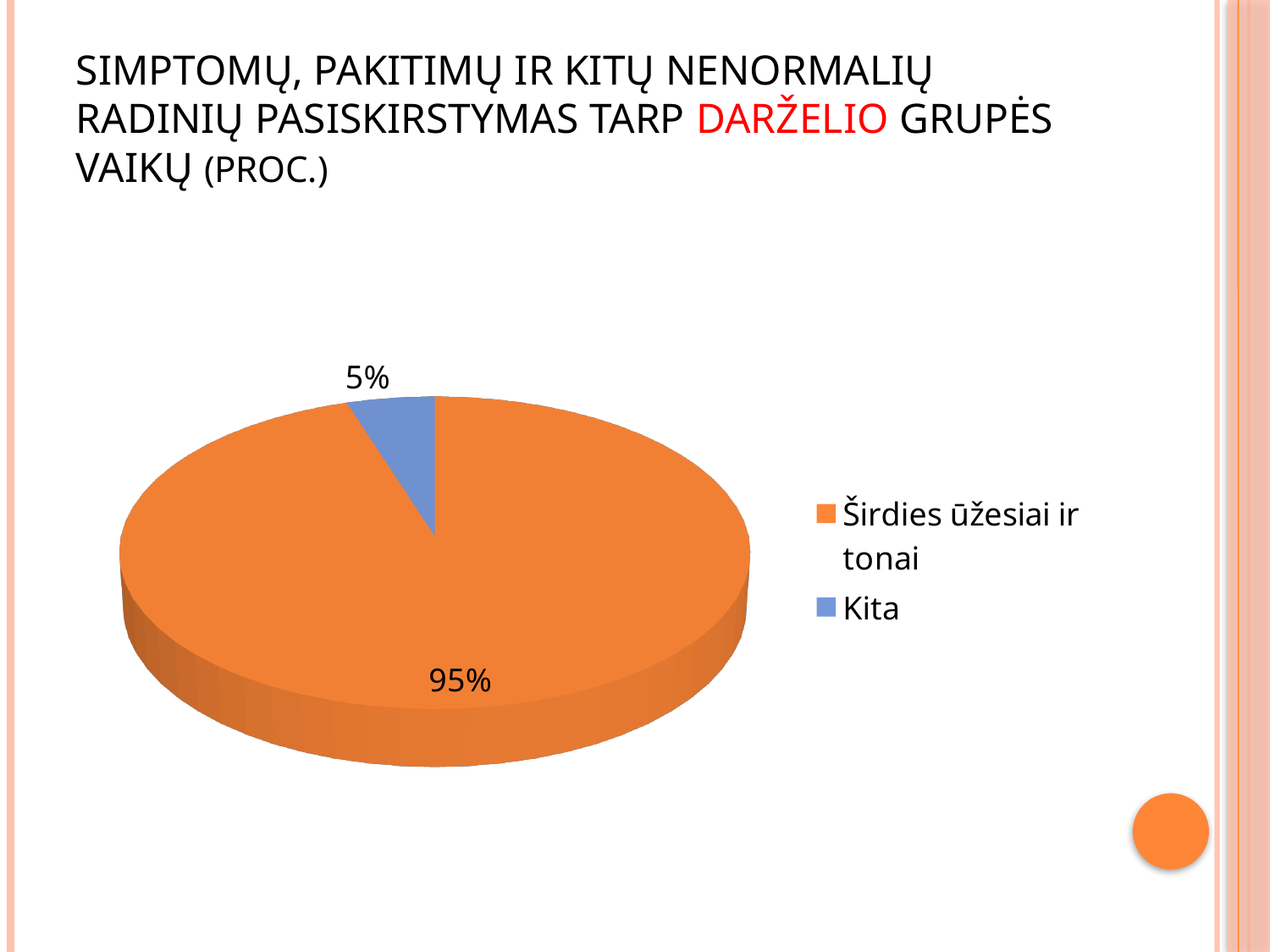
What share of the pie does "Kita" take? 5% Which category has the largest slice of the pie? Širdies ūžesiai ir tonai What is the difference in percentage points between "Širdies ūžesiai ir tonai" and "Kita"? 90 What colour is the slice for "Širdies ūžesiai ir tonai"? orange Which category has the smallest slice of the pie? Kita How many categories does the pie chart show? 2 What share of the pie does "Širdies ūžesiai ir tonai" take? 95% Which is larger, the slice for "Kita" or the slice for "Širdies ūžesiai ir tonai"? Širdies ūžesiai ir tonai How many entries does the legend list? 2 What kind of chart is shown on the slide? pie chart What colour is the slice for "Kita"? blue